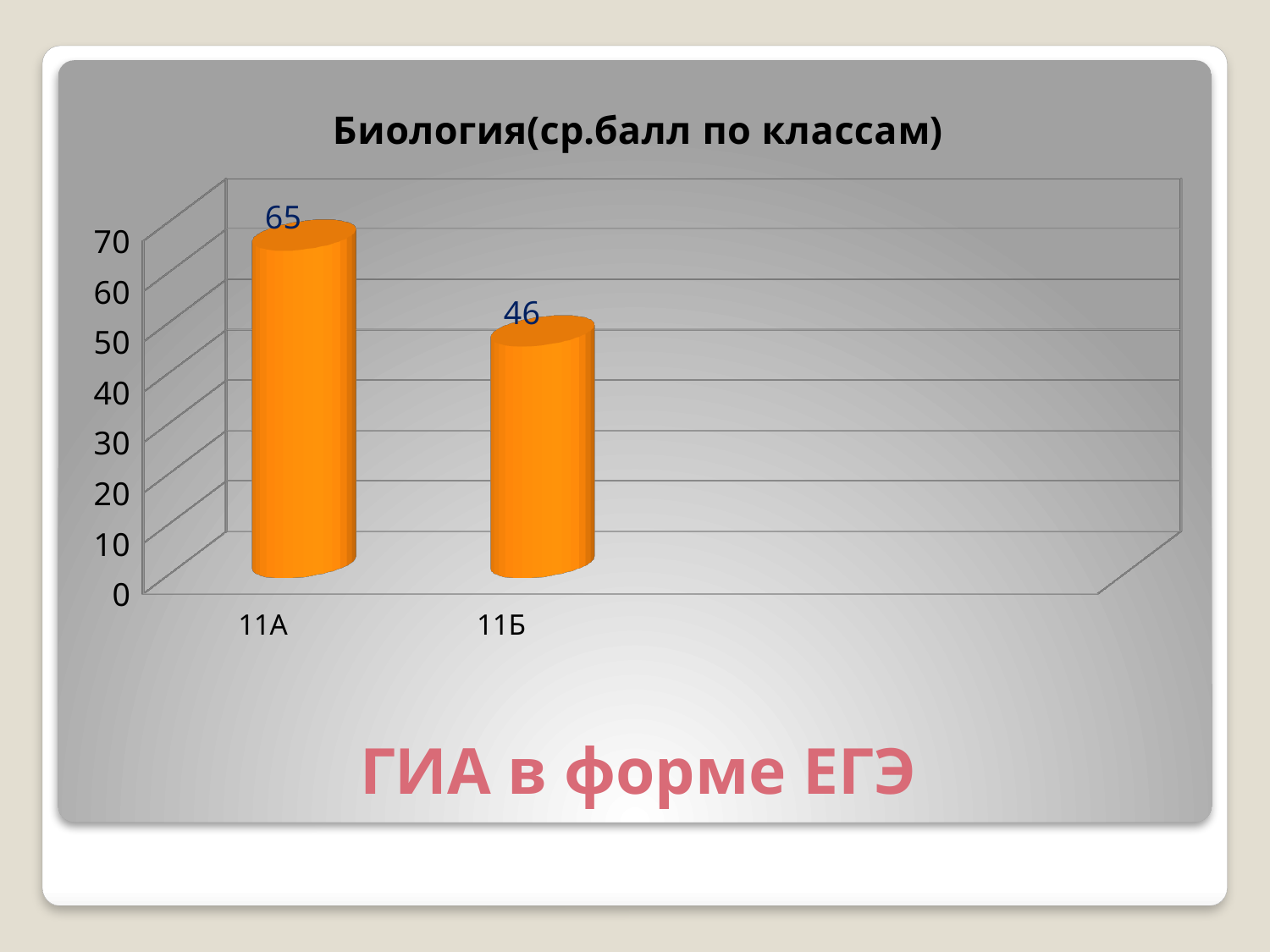
What is the average biology score for class 11Б? 46 How many classes are shown on the chart? 2 What kind of chart is shown on the slide? bar chart What is the difference between the average biology scores of 11А and 11Б? 19 Which class has the highest average biology score? 11А What colour are the bars on the chart? orange What is the title of the chart? Биология(ср.балл по классам) Which class has a higher average biology score, 11А or 11Б? 11А Which class has the lowest average biology score? 11Б What is the average biology score for class 11А? 65 Is the value for 11А greater or less than 60? greater Is the value for 11Б greater or less than 50? less